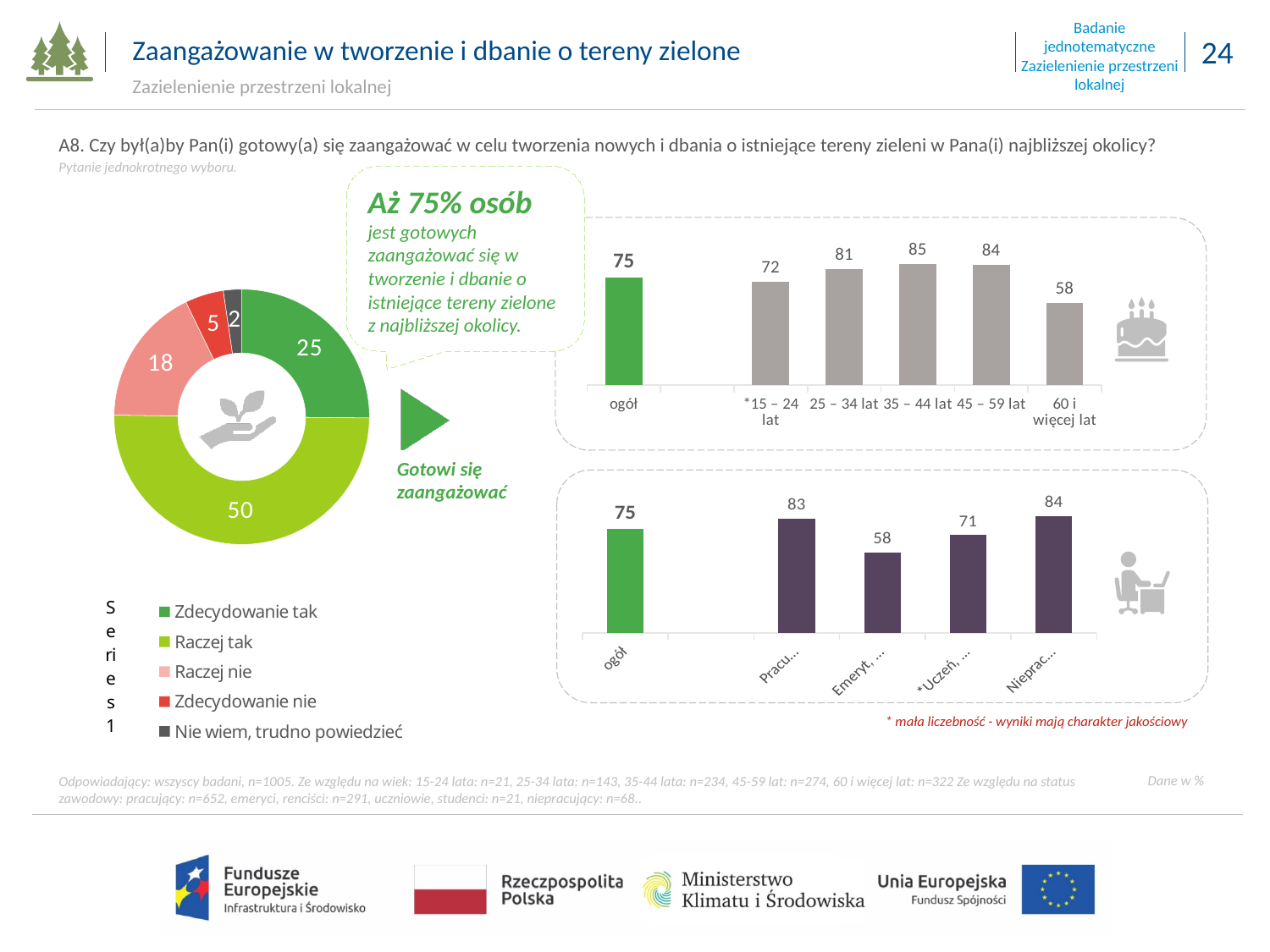
In the top-right bar chart by age, how many bars are plotted? 6 In the donut chart on the left, what is the combined value of 'Zdecydowanie tak' and 'Raczej tak'? 75 In the top-right bar chart by age, what is the value for '35 – 44 lat'? 85 How many response categories does the legend of the donut chart list? 5 In the top-right bar chart by age, which age group has the lowest value? 60 i więcej lat In the donut chart on the left, which response category has the largest share? Raczej tak In the donut chart on the left, which response category has the smallest share? Nie wiem, trudno powiedzieć In the bottom-right bar chart by employment status, what is the value for 'ogół'? 75 In the donut chart on the left, what value is shown for 'Zdecydowanie nie'? 5 In the donut chart on the left, what percentage of respondents answered 'Raczej tak'? 50 What type of chart is shown in the bottom-right panel? bar chart In the top-right bar chart by age, what is the difference between the values for '25 – 34 lat' and '*15 – 24 lat'? 9